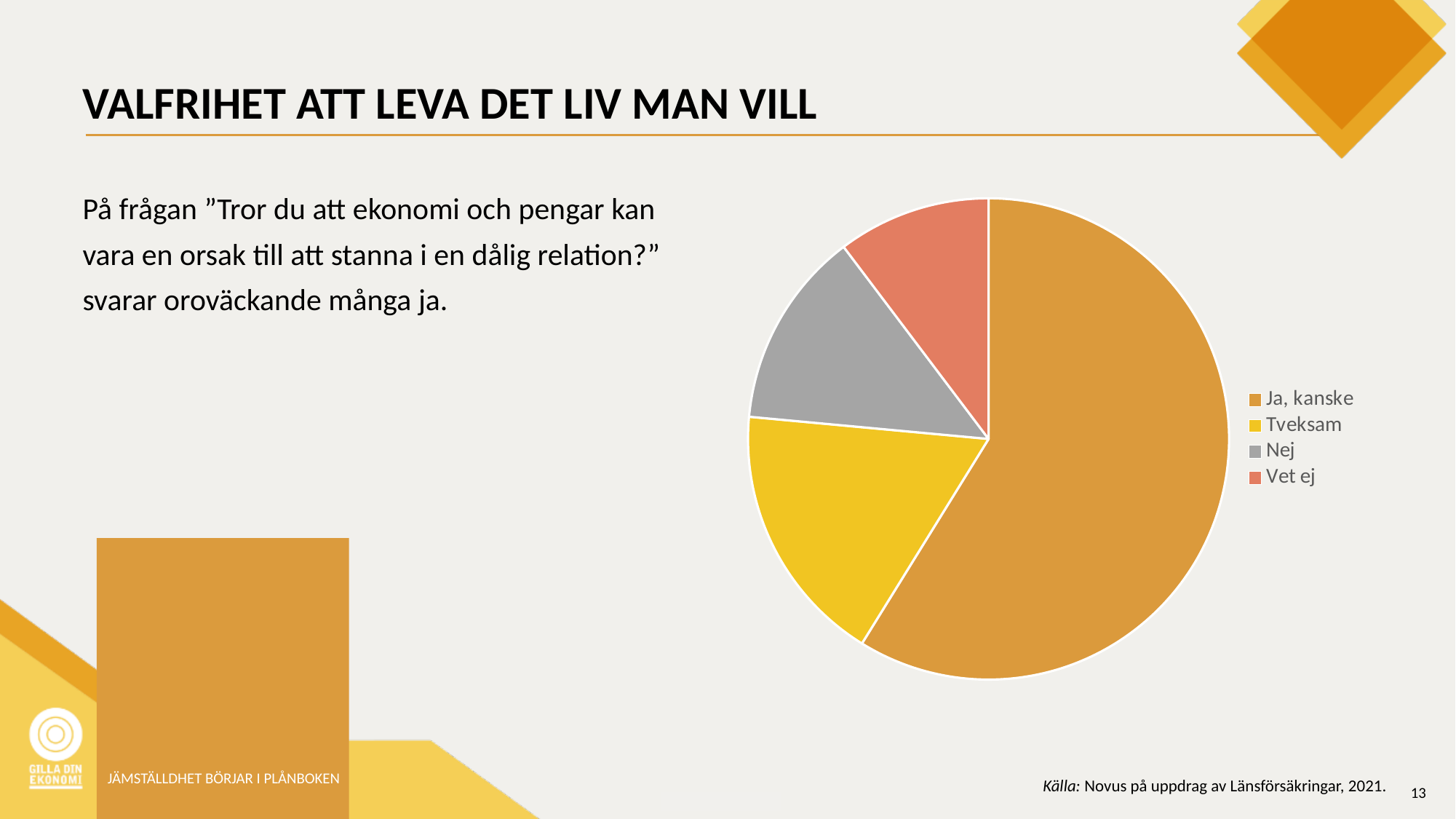
Which slice is larger in the pie chart, "Tveksam" or "Nej"? Tveksam Which category in the legend is shown in grey? Nej How many entries does the legend of the pie chart list? 4 Does the "Ja, kanske" slice take up more or less than half of the pie chart? More Which category has the smallest slice in the pie chart? Vet ej How many slices does the pie chart have? 4 Which slice is larger in the pie chart, "Nej" or "Vet ej"? Nej What kind of chart is shown on the slide? Pie chart Which category has the largest slice in the pie chart? Ja, kanske What colour is the "Tveksam" slice in the pie chart? Yellow